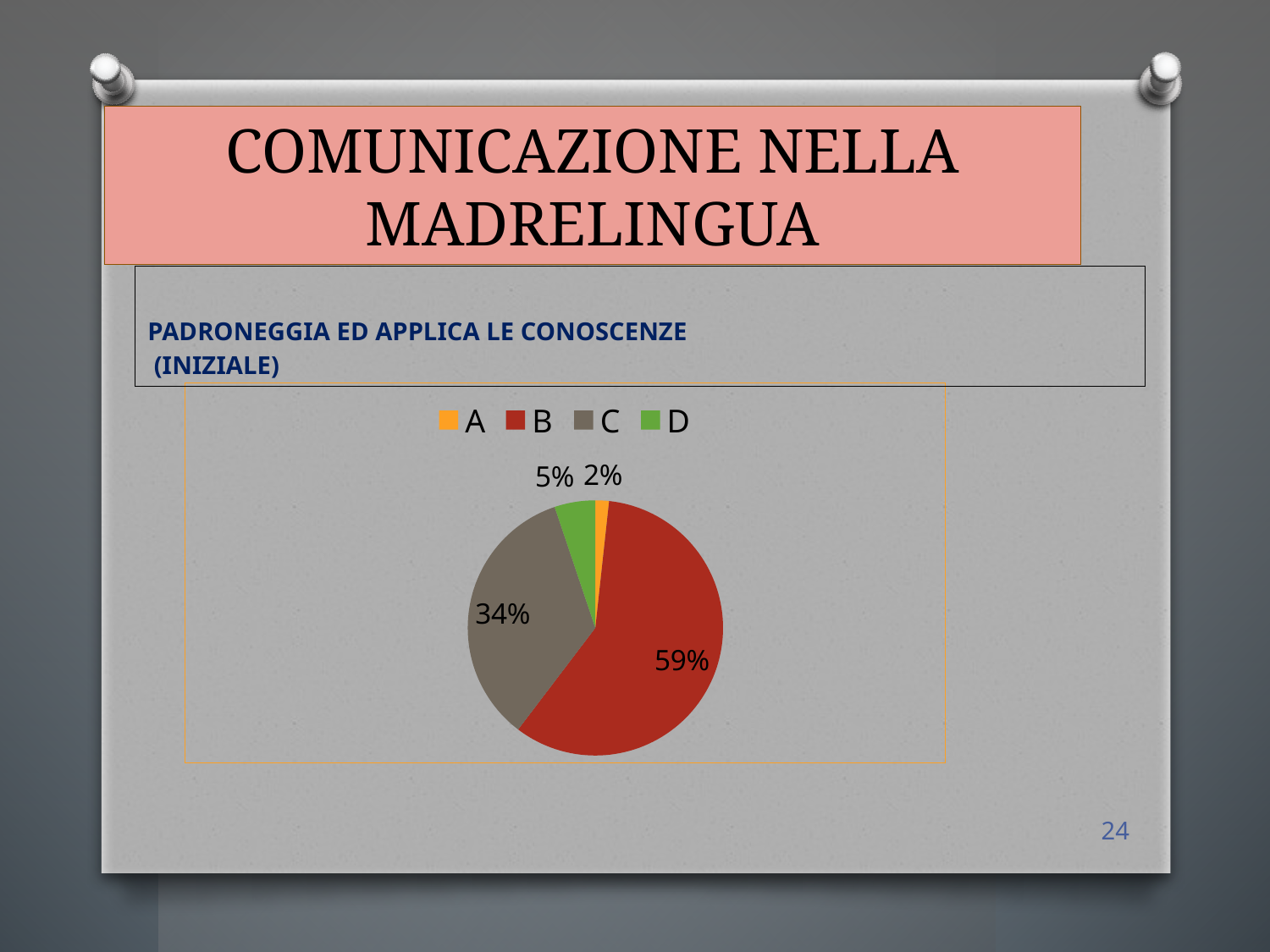
How many slices does the pie chart have? 4 What colour is slice B in the pie chart? red Which is larger, slice C or slice D? C What percentage does slice B represent in the pie chart? 59% What percentage does slice C represent in the pie chart? 34% Which category has the smallest slice in the pie chart? A What is the difference in percentage points between slices B and C? 25 What kind of chart is shown on the slide? pie chart Which category has the largest slice in the pie chart? B What percentage does slice A represent in the pie chart? 2% What percentage does slice D represent in the pie chart? 5% How many categories does the legend list? 4